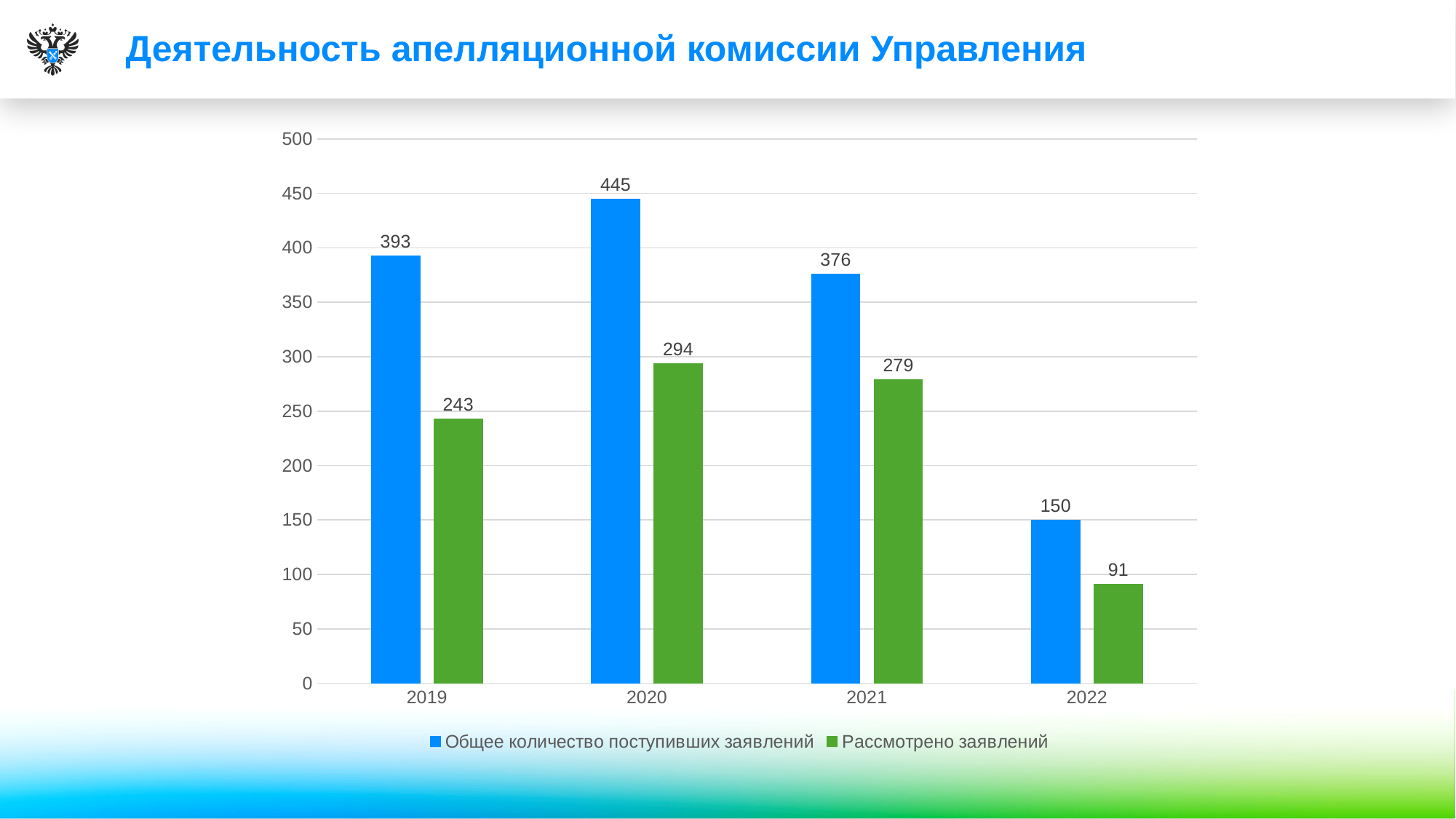
What is the difference between 'Общее количество поступивших заявлений' in 2020 and in 2021? 69 How many series does the legend list? 2 Is the value for 'Общее количество поступивших заявлений' in 2021 greater or less than 350? greater What is the value of 'Рассмотрено заявлений' for 2022? 91 Which year has the lowest value for 'Рассмотрено заявлений'? 2022 What is the value of 'Общее количество поступивших заявлений' for 2020? 445 What is the difference between 'Общее количество поступивших заявлений' and 'Рассмотрено заявлений' in 2019? 150 Which is larger: 'Рассмотрено заявлений' in 2020 or in 2021? 2020 What kind of chart is shown on the slide? bar chart How many years are shown on the x axis? 4 Which year has the highest value for 'Общее количество поступивших заявлений'? 2020 What is the value of 'Рассмотрено заявлений' for 2021? 279